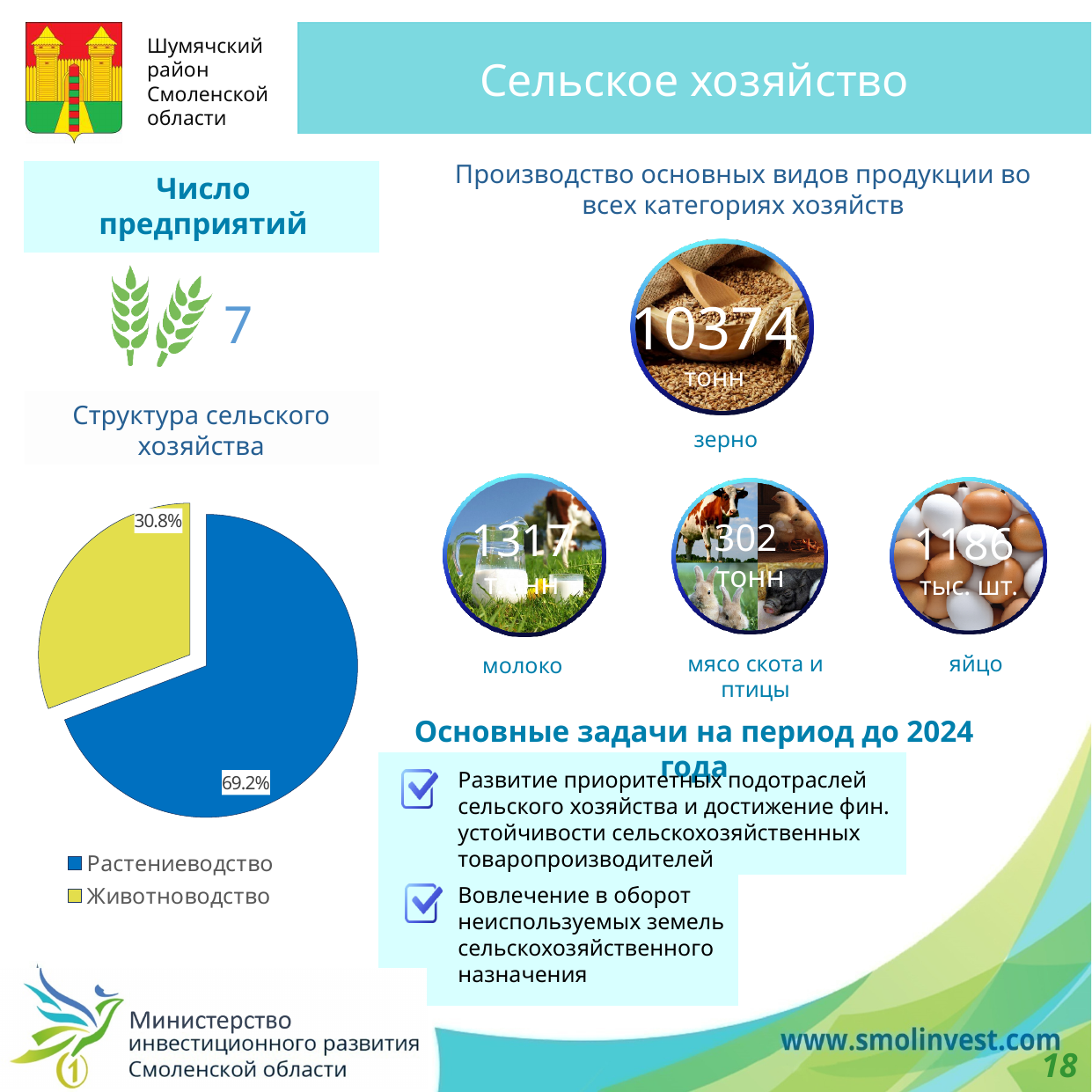
Which slice of the pie chart "Структура сельского хозяйства" is the largest? Растениеводство In the pie chart "Структура сельского хозяйства", what share does Животноводство have? 30.8% What kind of chart is shown under the heading "Структура сельского хозяйства"? pie chart In the pie chart "Структура сельского хозяйства", which is larger: Растениеводство or Животноводство? Растениеводство In the pie chart "Структура сельского хозяйства", what share does Растениеводство have? 69.2% In the pie chart "Структура сельского хозяйства", what colour is the Животноводство slice? yellow Which slice of the pie chart "Структура сельского хозяйства" is the smallest? Животноводство How many slices does the pie chart "Структура сельского хозяйства" have? 2 In the pie chart "Структура сельского хозяйства", by how many percentage points does Растениеводство exceed Животноводство? 38.4 In the pie chart "Структура сельского хозяйства", what colour is the Растениеводство slice? blue How many entries does the legend of the pie chart "Структура сельского хозяйства" list? 2